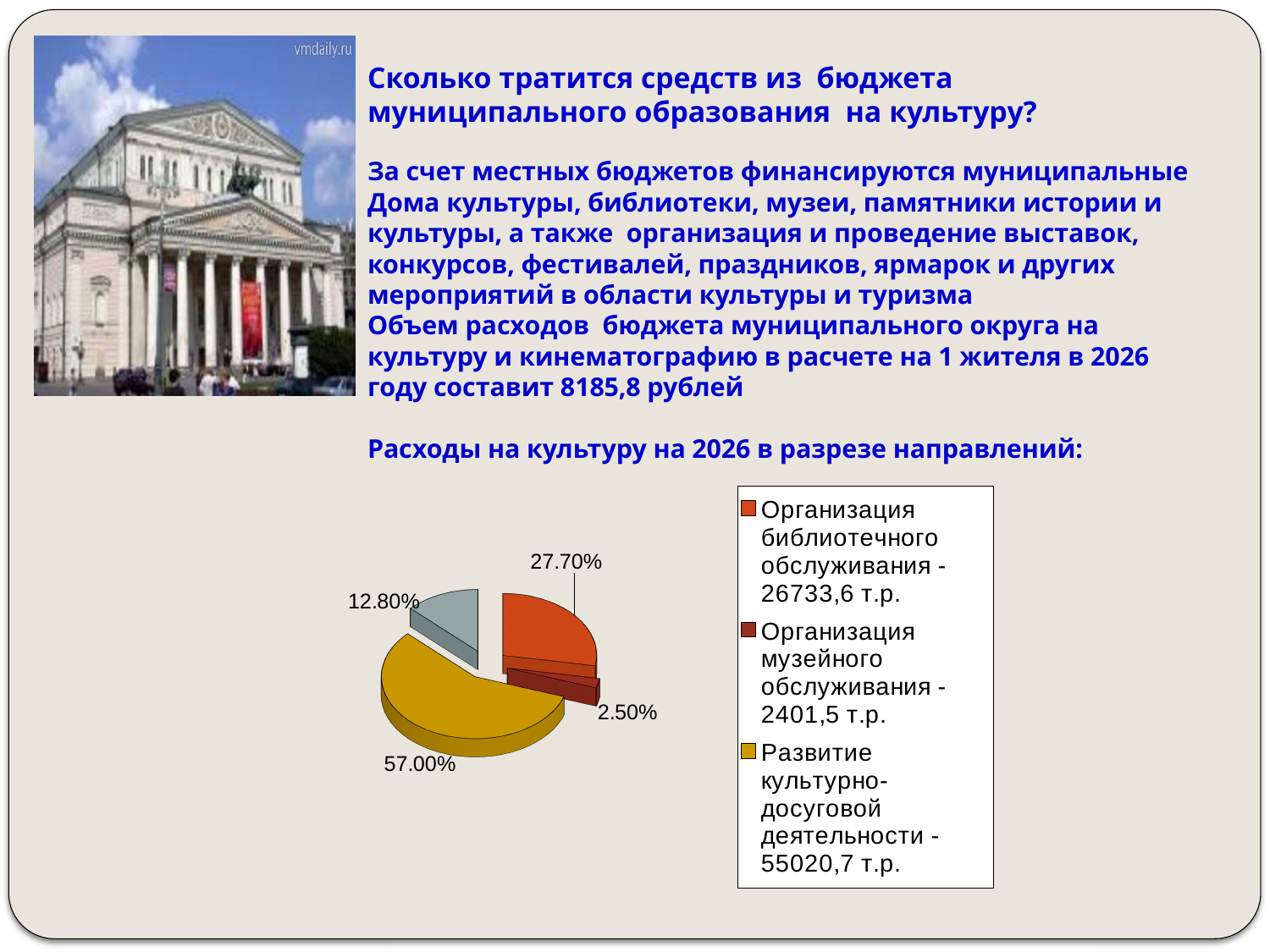
What kind of chart is shown on the slide? pie chart Which category has the largest slice of the pie? Развитие культурно-досуговой деятельности According to the legend, what amount in т.р. is given for Организация библиотечного обслуживания? 26733,6 т.р. What is the difference in percentage points between the largest slice (57.00%) and the slice for Организация библиотечного обслуживания (27.70%)? 29.30 What share of the pie does the slice for Организация библиотечного обслуживания (orange) represent? 27.70% What percentage label is shown on the grey slice of the pie? 12.80% What share of the pie does the slice for Организация музейного обслуживания (dark red) represent? 2.50% How many slices does the pie chart have? 4 How many entries does the legend list? 3 What share of the pie does the slice for Развитие культурно-досуговой деятельности (yellow) represent? 57.00% Which category has the smallest slice of the pie? Организация музейного обслуживания Which is larger: the slice for Организация библиотечного обслуживания or the slice for Организация музейного обслуживания? Организация библиотечного обслуживания